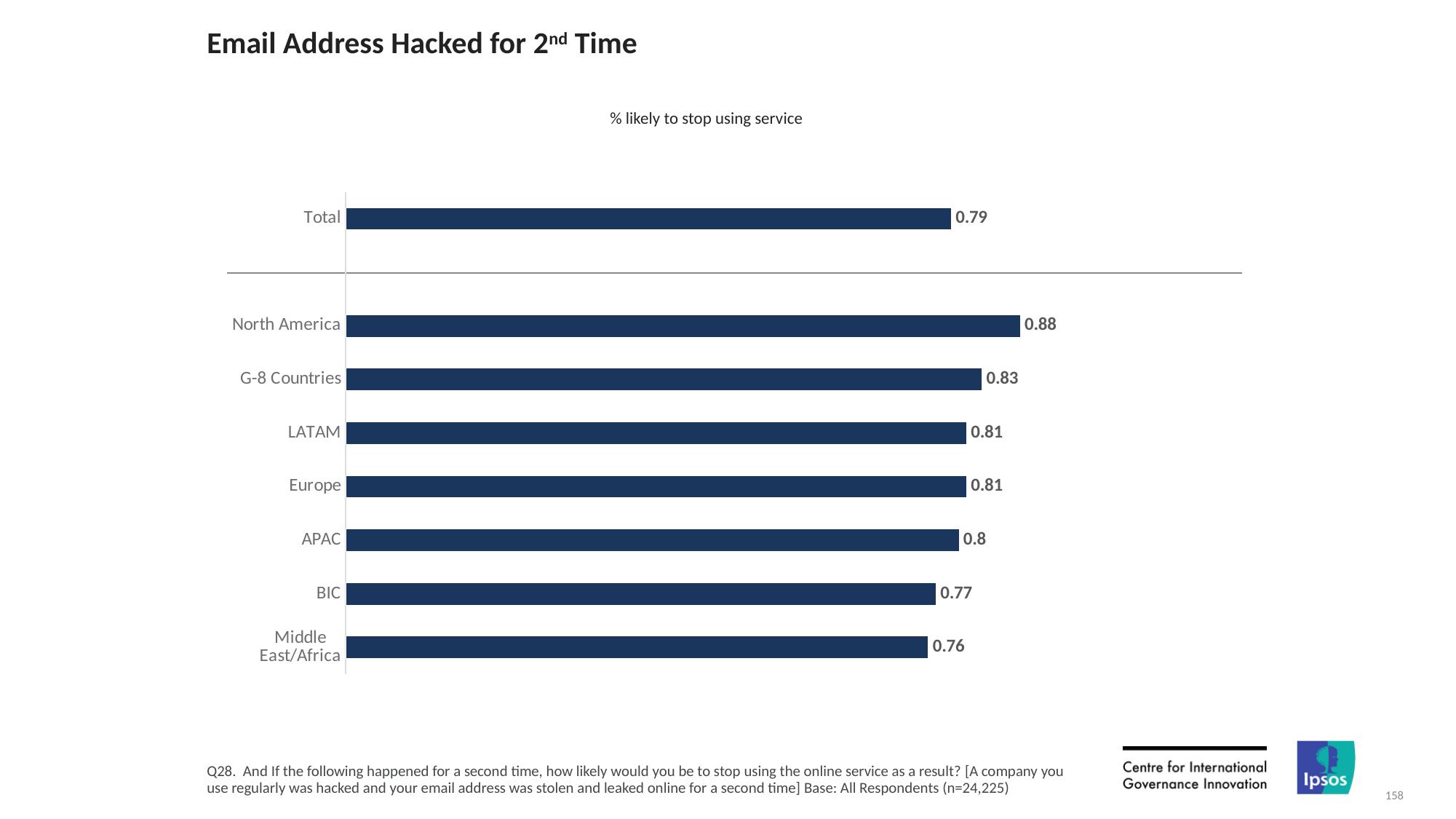
What is the value for APAC? 0.8 What kind of chart is shown on the slide? Bar chart What is the difference between the values for North America and Middle East/Africa? 0.12 Which is larger, the value for G-8 Countries or the value for BIC? G-8 Countries Which region has the highest value? North America What is the difference between the values for G-8 Countries and BIC? 0.06 What is the subtitle shown above the chart? % likely to stop using service Which region has the lowest value? Middle East/Africa What is the value for Total? 0.79 What is the value for North America? 0.88 What is the value for Middle East/Africa? 0.76 How many bars are shown in the chart? 8